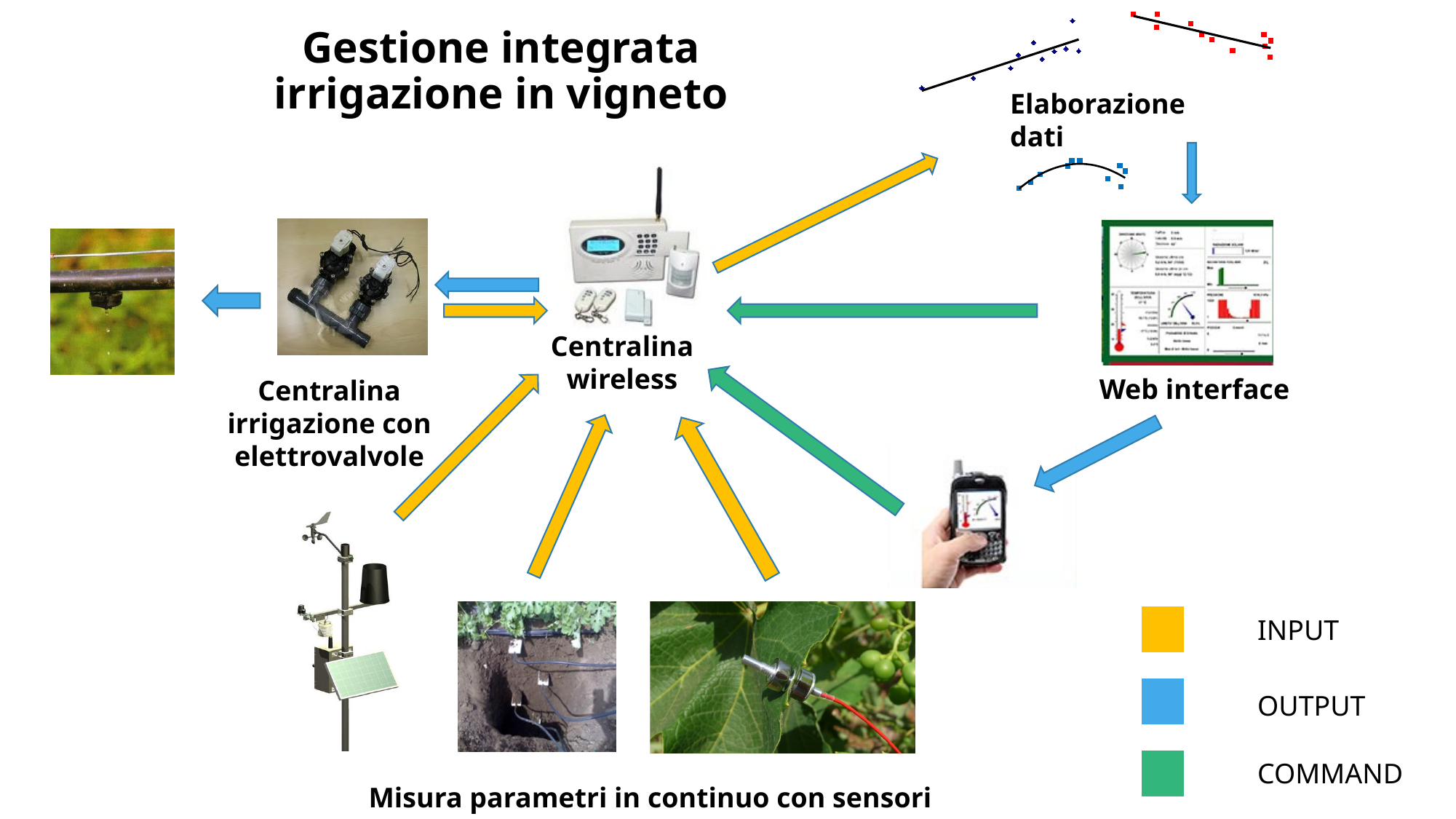
What kind of charts are the three small plots in the top-right area of the slide, near the label 'Elaborazione dati'? scatter plots with fitted lines In the red scatter plot at the top-right corner of the slide, do the points rise or fall from left to right? fall In the blue scatter plot at the top of the slide (the upper-left of the three small plots), do the points rise or fall from left to right? rise What label is printed next to the three small scatter plots in the top-right area of the slide? Elaborazione dati How many small scatter plots are shown in the top-right area of the slide near 'Elaborazione dati'? 3